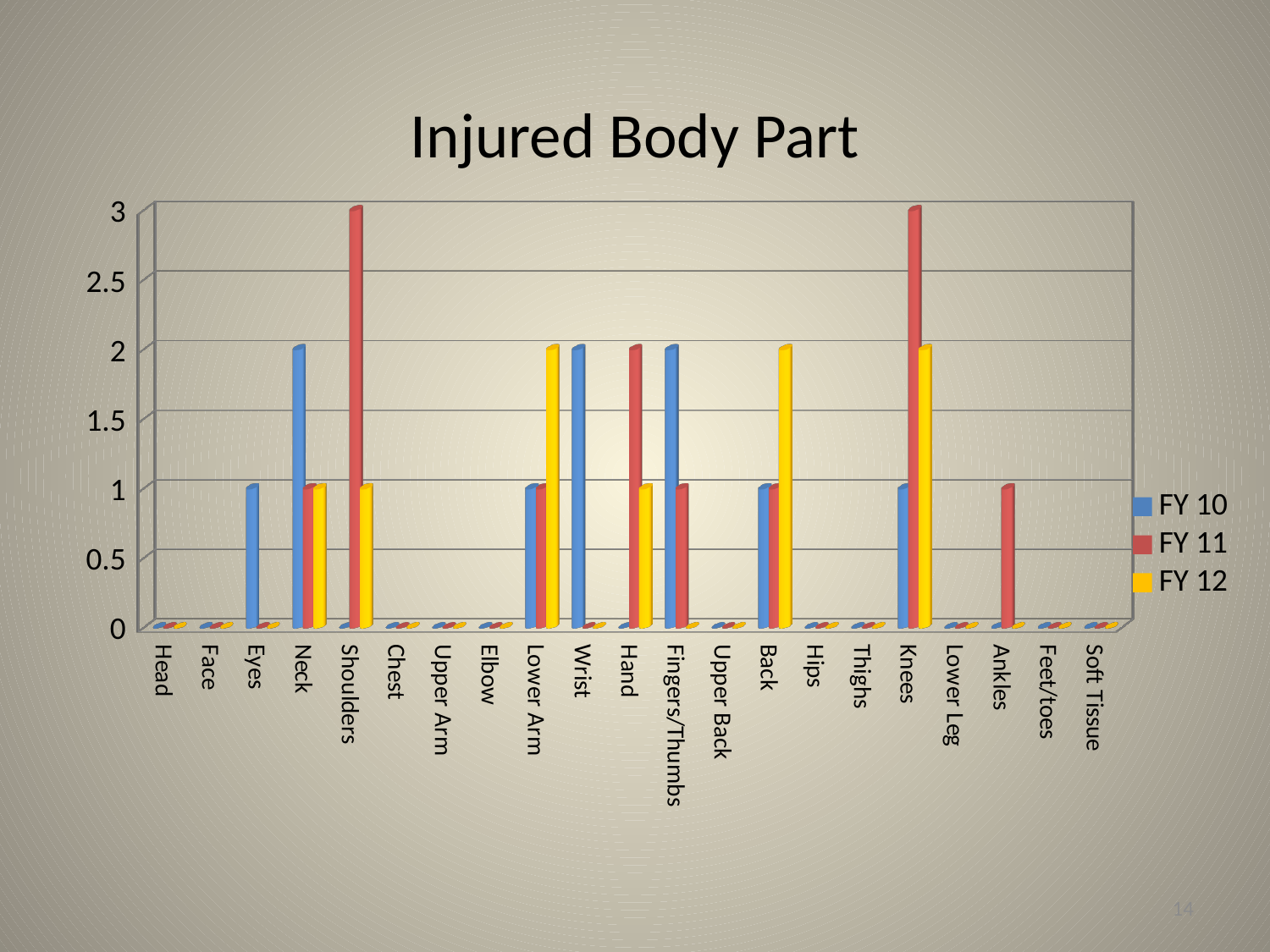
How many series does the legend list? 3 What is the FY 11 value for Hand? 2 What is the difference between the FY 11 value for Knees and the FY 10 value for Knees? 2 What is the FY 11 value for Shoulders? 3 What is the FY 12 value for Knees? 2 Is the FY 11 value for Shoulders greater or less than 2? greater Which series is shown in yellow in the legend? FY 12 What is the title of the chart? Injured Body Part Which body part has the highest FY 10 value, Wrist or Eyes? Wrist What is the FY 10 value for Neck? 2 What kind of chart is shown on the slide? bar chart How many body part categories are shown on the x axis? 21